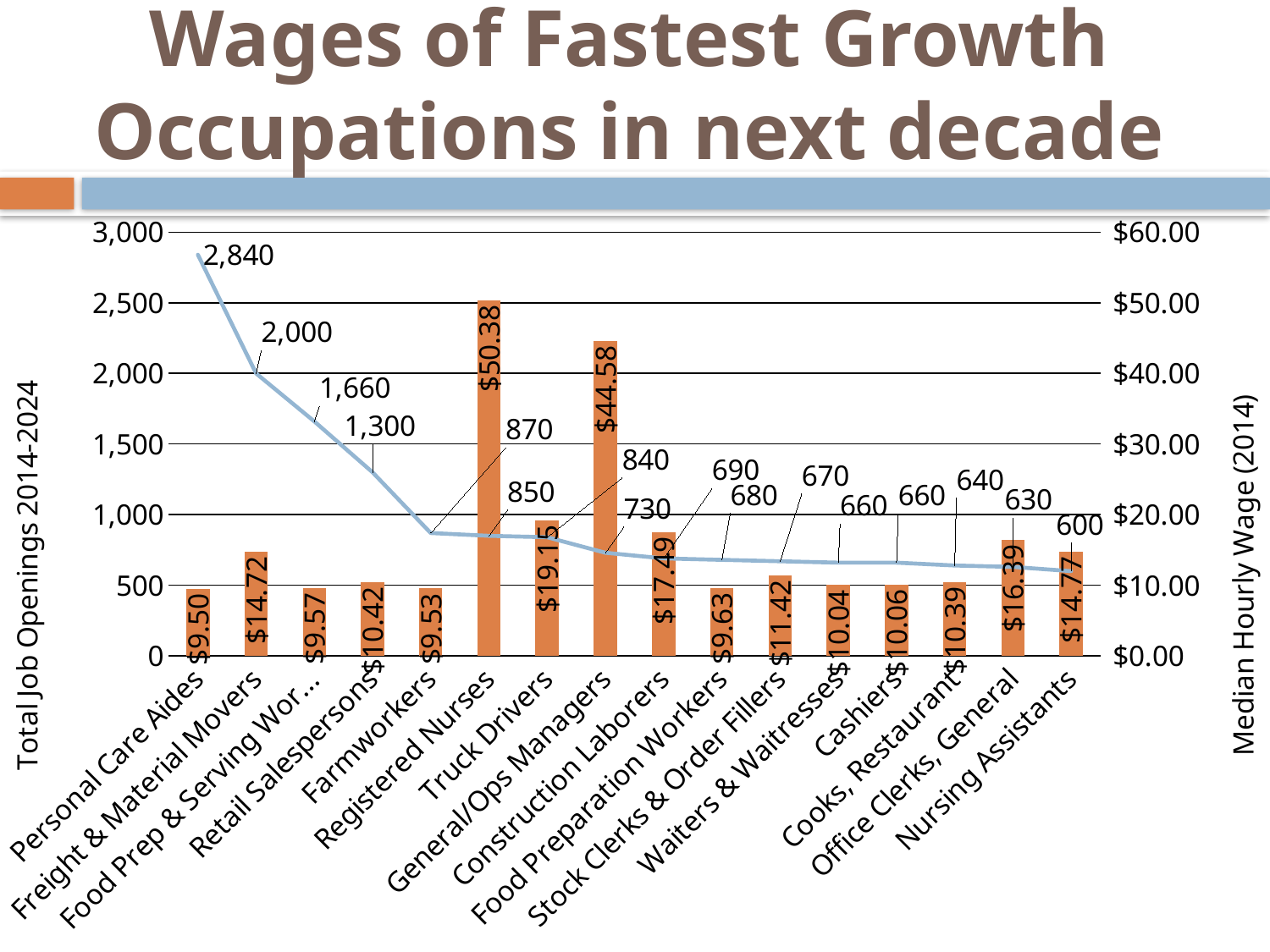
Does the job openings line rise or fall from left to right across the occupations? Fall What kind of chart is this? Combination bar and line chart What is the difference in total job openings between Personal Care Aides and Freight & Material Movers? 840 How many occupations are shown on the chart? 16 What is the median hourly wage shown for Office Clerks, General? $16.39 Which occupation has the highest median hourly wage? Registered Nurses What is the difference in median hourly wage between Registered Nurses and General/Ops Managers? $5.80 Is the median hourly wage for General/Ops Managers greater or less than $40.00? greater Which has a higher median hourly wage, Truck Drivers or Construction Laborers? Truck Drivers Which occupation has the lowest total job openings on the line? Nursing Assistants What is the median hourly wage shown for Registered Nurses? $50.38 How many total job openings (2014-2024) are shown for Personal Care Aides? 2,840